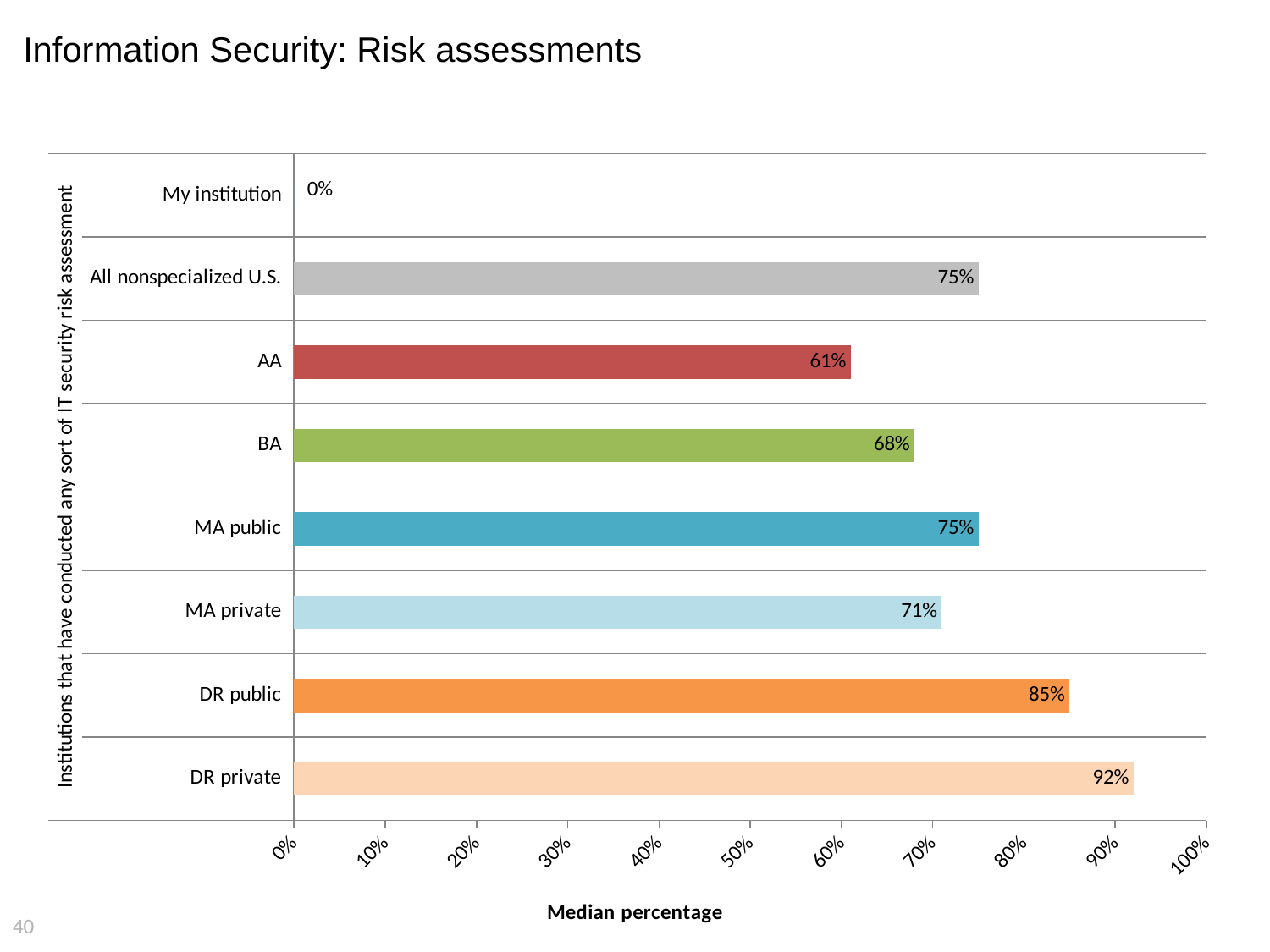
What is the value for All nonspecialized U.S.? 75% Is the value for DR public greater or less than 80%? greater Which is larger, the value for MA public or the value for MA private? MA public Which category has the lowest value? My institution What is the value for AA? 61% Which category has the highest value? DR private What is the difference between the values for DR public and BA? 17% What kind of chart is shown on the slide? bar chart What is the label of the horizontal axis? Median percentage What is the value for DR private? 92% How many categories are shown on the chart? 8 What is the value for MA private? 71%